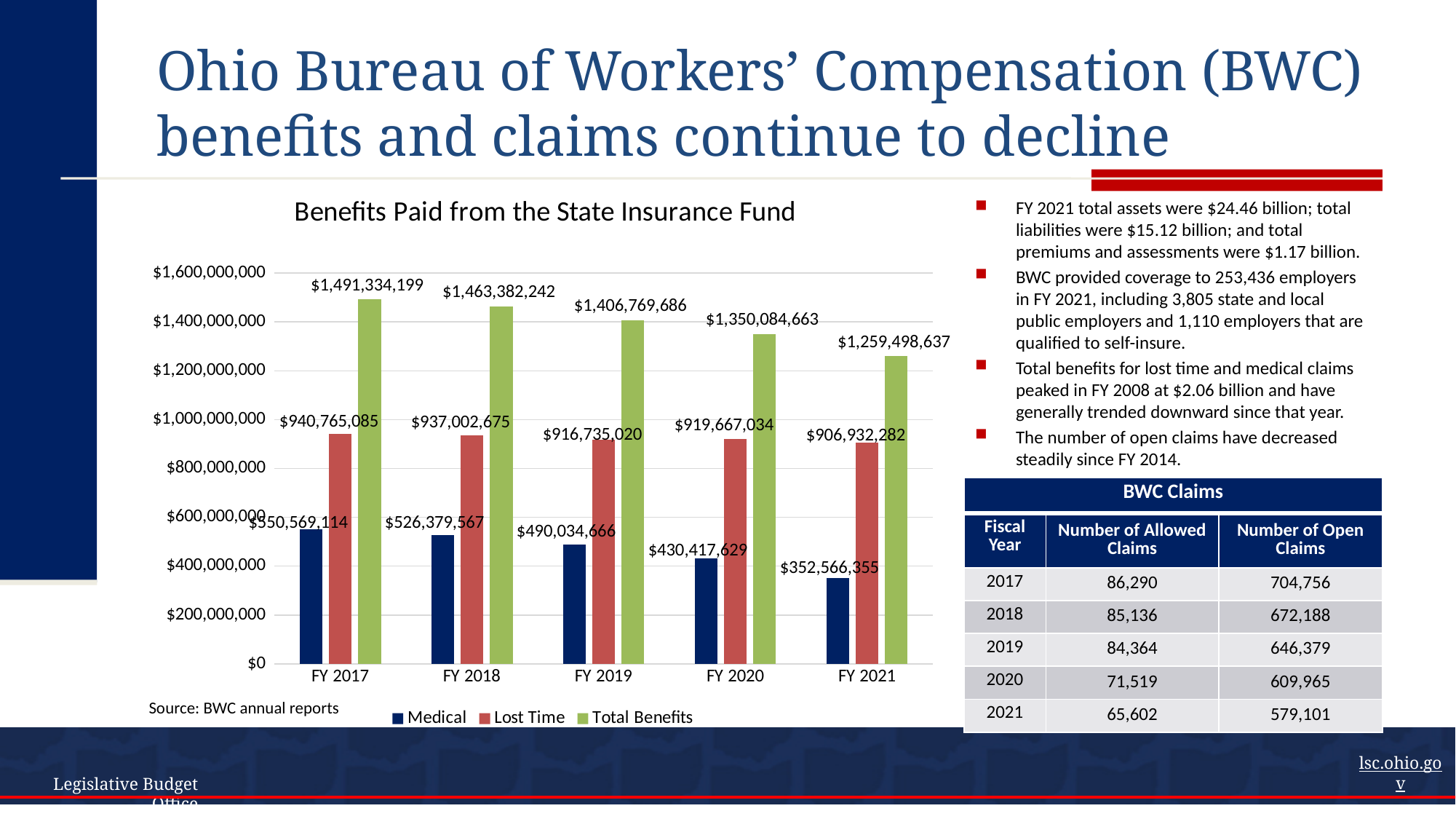
In the Benefits Paid from the State Insurance Fund chart, which fiscal year has the highest Total Benefits? FY 2017 What kind of chart is the Benefits Paid from the State Insurance Fund chart? bar chart In the Benefits Paid from the State Insurance Fund chart, is the Medical value for FY 2021 greater or less than $400,000,000? less In the Benefits Paid from the State Insurance Fund chart, is the Lost Time value larger in FY 2018 or FY 2020? FY 2018 How many fiscal years are shown on the x axis of the Benefits Paid from the State Insurance Fund chart? 5 In the Benefits Paid from the State Insurance Fund chart, which fiscal year has the lowest Medical value? FY 2021 In the Benefits Paid from the State Insurance Fund chart, what is the difference between Total Benefits in FY 2017 and FY 2021? $231,835,562 In the Benefits Paid from the State Insurance Fund chart, what is the Total Benefits value for FY 2021? $1,259,498,637 In the Benefits Paid from the State Insurance Fund chart, what is the Medical value for FY 2020? $430,417,629 How many series does the legend of the Benefits Paid from the State Insurance Fund chart list? 3 In the Benefits Paid from the State Insurance Fund chart, what is the Lost Time value for FY 2019? $916,735,020 In the Benefits Paid from the State Insurance Fund chart, do the Total Benefits values rise or fall from FY 2017 to FY 2021? fall